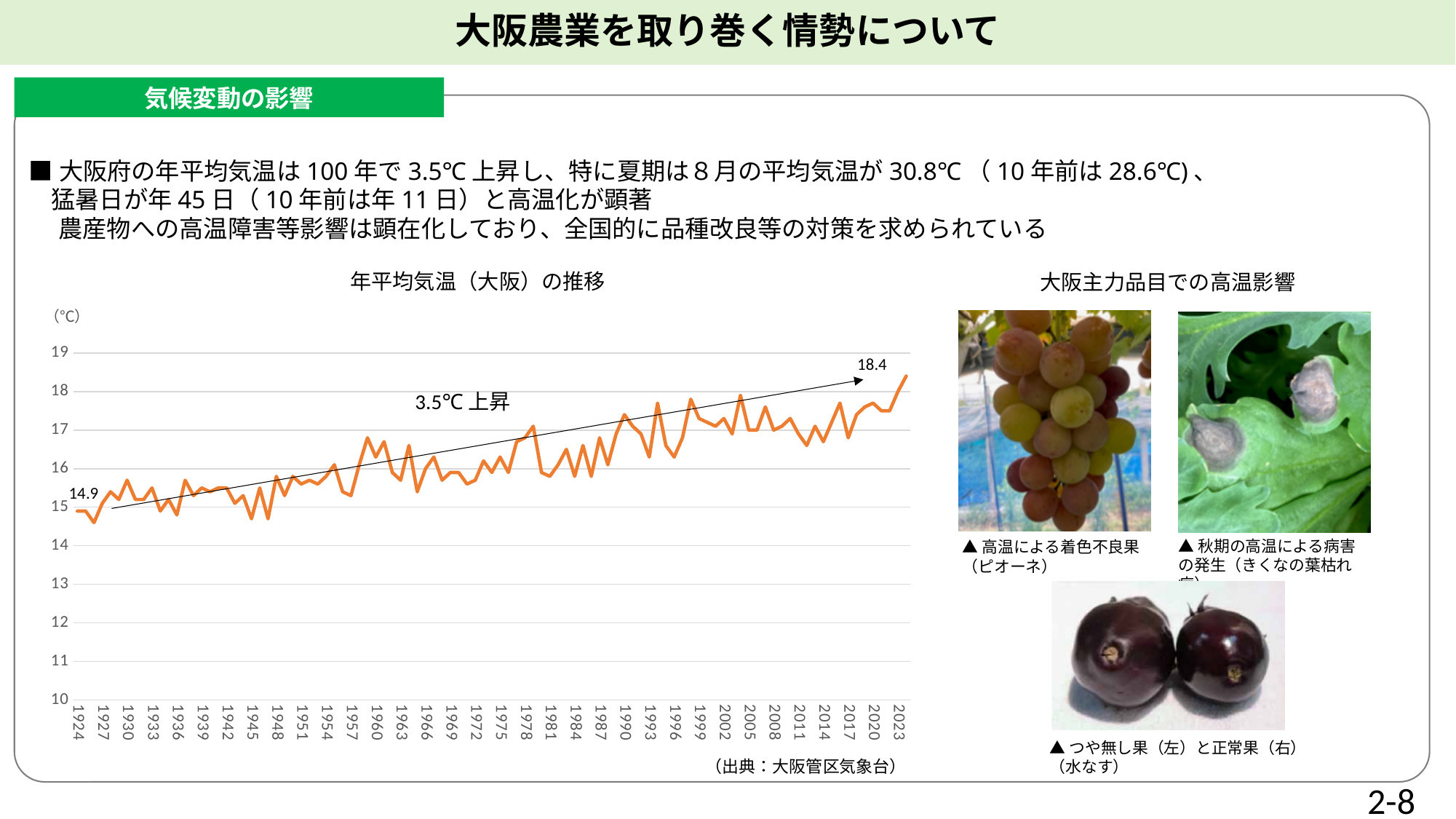
What is the source cited below the chart 年平均気温（大阪）の推移? 大阪管区気象台 Is the value for 1945 in the chart greater or less than 15? less Which is larger in the chart: the value for 2023 or the value for 1924? 2023 What text does the arrow annotation on the chart show? 3.5℃ 上昇 How many data series are plotted in the chart 年平均気温（大阪）の推移? 1 By how much does the labelled 2023 value (18.4) exceed the labelled 1924 value (14.9) in the chart? 3.5 Does the annual mean temperature in the chart 年平均気温（大阪）の推移 generally rise or fall from 1924 to 2023? rise What kind of chart is 年平均気温（大阪）の推移? line chart What is the value labelled at the start of the line (1924) in the chart 年平均気温（大阪）の推移? 14.9